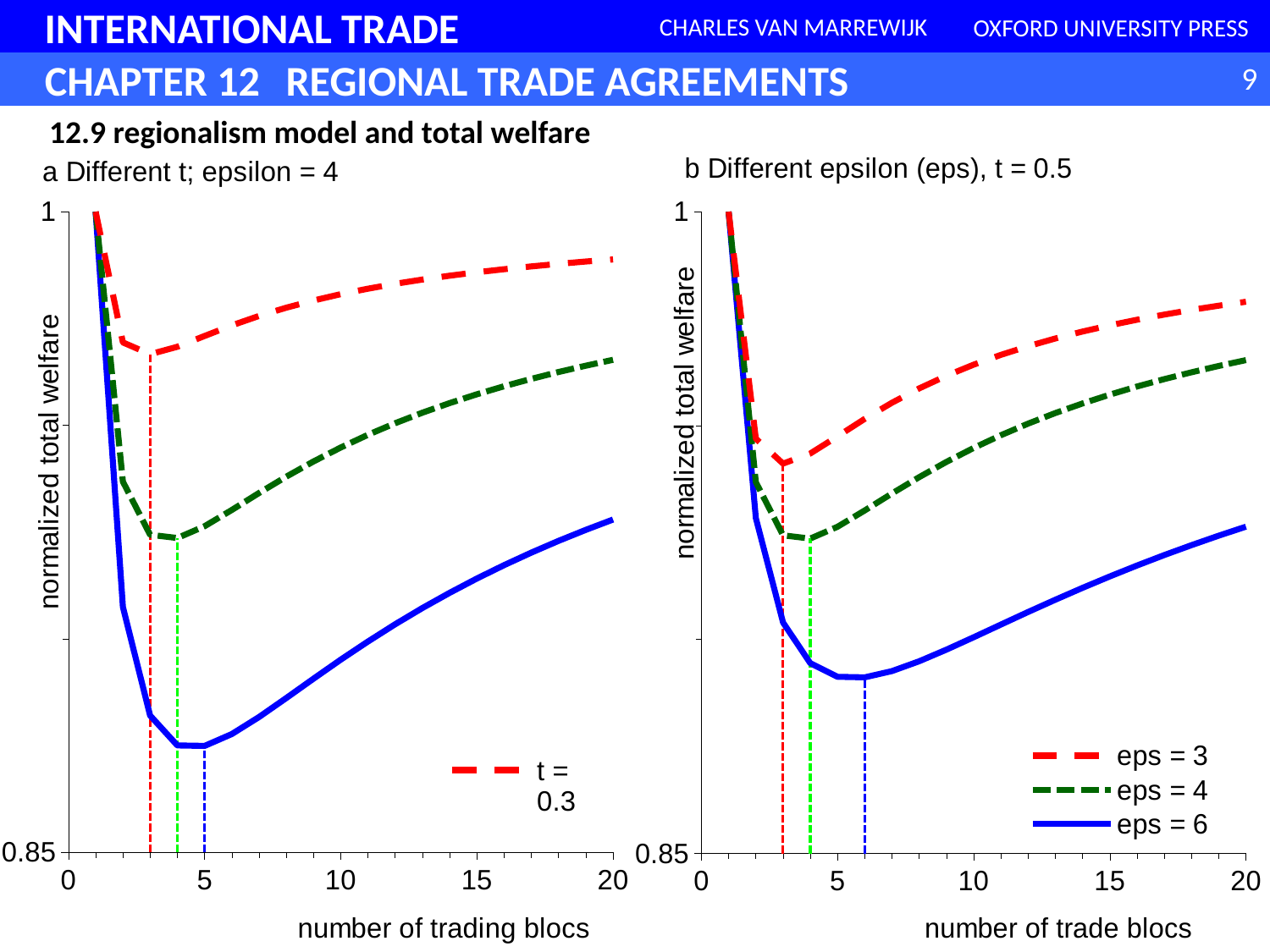
In the right chart, 'b Different epsilon (eps), t = 0.5', which series has the highest normalized total welfare at 20 trade blocs? eps = 3 In the left chart, 'a Different t; epsilon = 4', at what number of trading blocs does the solid blue line reach its minimum, as marked by the dashed vertical line? 5 In the right chart, 'b Different epsilon (eps), t = 0.5', does the eps = 6 line rise or fall as the number of trade blocs increases from 10 to 20? rise What kind of chart is the left chart, 'a Different t; epsilon = 4'? line chart In the right chart, 'b Different epsilon (eps), t = 0.5', is the value for eps = 3 at 20 trade blocs greater or less than 1? less In the left chart, 'a Different t; epsilon = 4', does the solid blue line rise or fall as the number of trading blocs increases from 1 to 3? fall How many series does the legend of the right chart, 'b Different epsilon (eps), t = 0.5', list? 3 How many series does the legend of the left chart, 'a Different t; epsilon = 4', list? 1 In the right chart, 'b Different epsilon (eps), t = 0.5', which series has the lowest normalized total welfare at 20 trade blocs? eps = 6 What is the label of the y axis on the right chart, 'b Different epsilon (eps), t = 0.5'? normalized total welfare In the right chart, 'b Different epsilon (eps), t = 0.5', which is larger at 10 trade blocs: eps = 3 or eps = 6? eps = 3 What is the lowest value shown on the y axis of the left chart, 'a Different t; epsilon = 4'? 0.85